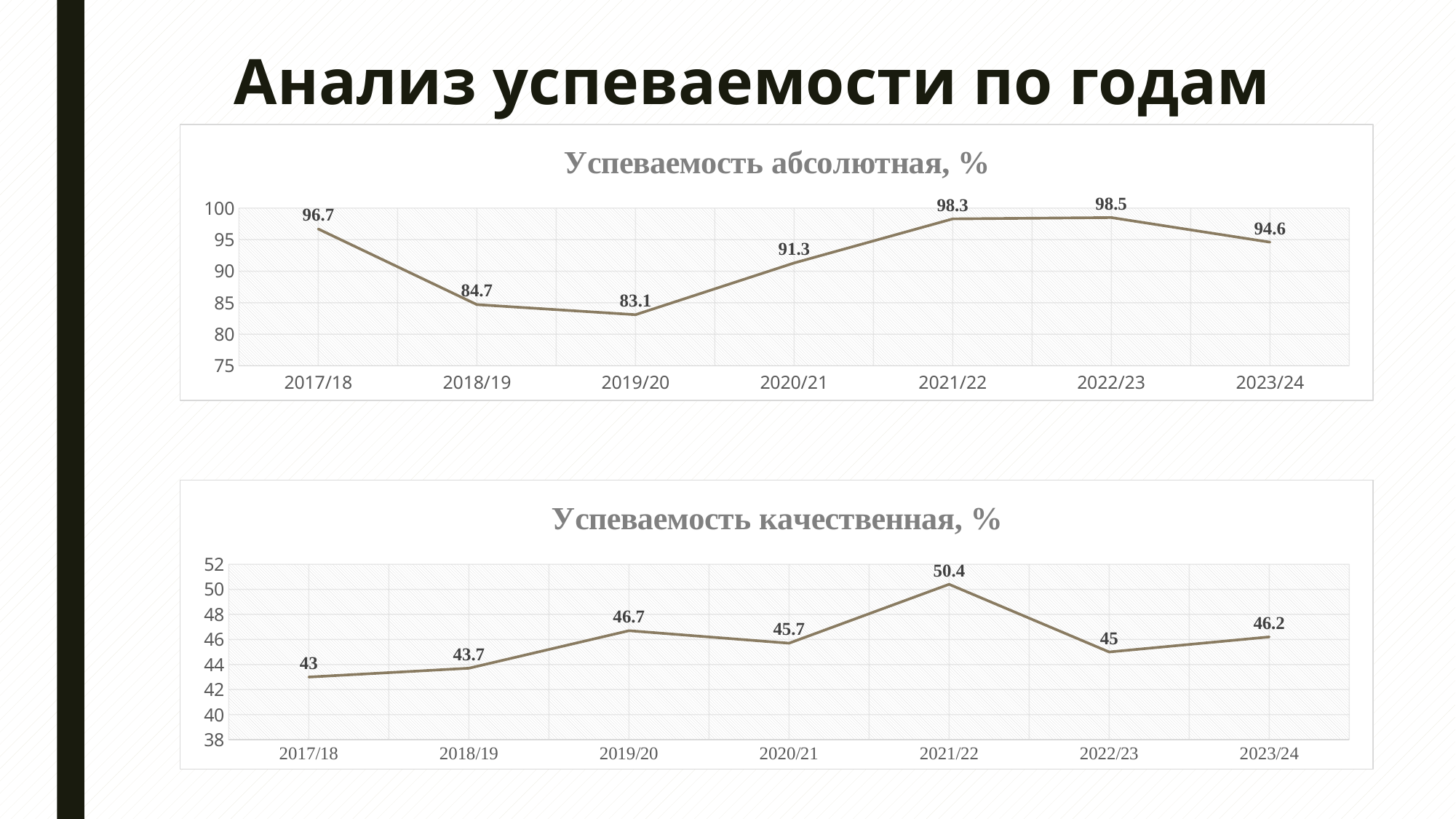
In the chart titled 'Успеваемость качественная, %', which year has the lowest value? 2017/18 In the chart titled 'Успеваемость качественная, %', what is the value for 2022/23? 45 In the chart titled 'Успеваемость абсолютная, %', what is the difference between the values for 2021/22 and 2020/21? 7 In the chart titled 'Успеваемость абсолютная, %', which year has the highest value? 2022/23 In the chart titled 'Успеваемость качественная, %', what is the difference between the values for 2021/22 and 2017/18? 7.4 In the chart titled 'Успеваемость абсолютная, %', do the values rise or fall from 2019/20 to 2022/23? Rise In the chart titled 'Успеваемость качественная, %', which is larger, the value for 2019/20 or the value for 2020/21? 2019/20 What type of chart is the top chart on the slide? Line chart In the chart titled 'Успеваемость качественная, %', which year has the highest value? 2021/22 In the chart titled 'Успеваемость абсолютная, %', what is the value for 2019/20? 83.1 In the chart titled 'Успеваемость абсолютная, %', how many data points are plotted? 7 In the chart titled 'Успеваемость абсолютная, %', which year has the lowest value? 2019/20